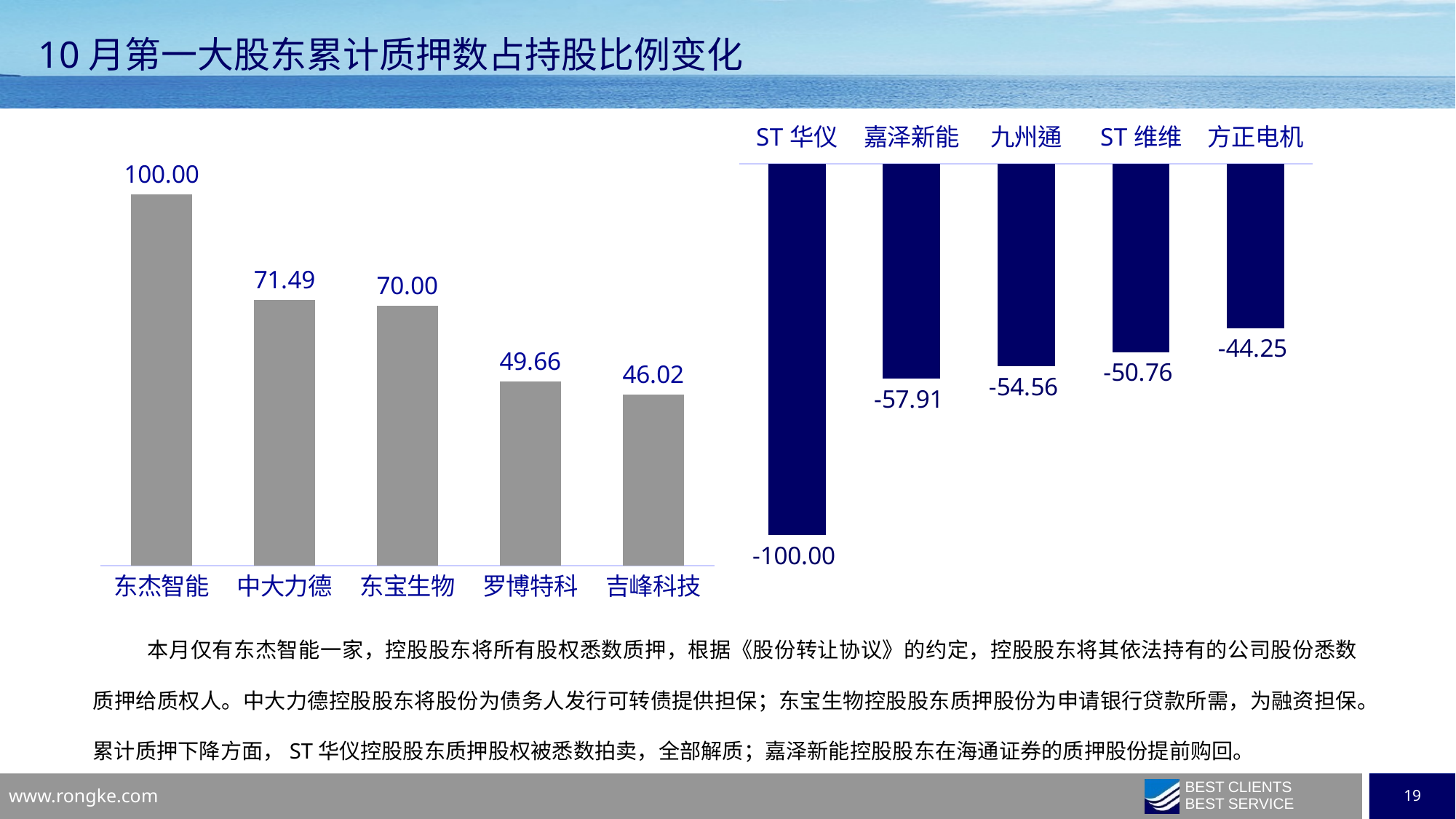
How many categories are shown in the right chart? 5 In the left chart, which category has the lowest value? 吉峰科技 In the left chart, which category has the highest value? 东杰智能 In the right chart, what is the value for 九州通? -54.56 In the left chart, what is the value for 吉峰科技? 46.02 In the right chart, what is the value for 方正电机? -44.25 In the right chart, which category has the lowest (most negative) value? ST 华仪 In the left chart, what is the value for 中大力德? 71.49 In the right chart, what is the difference between the values for 嘉泽新能 and ST 维维? 7.15 In the left chart, which is larger, the value for 罗博特科 or the value for 吉峰科技? 罗博特科 In the left chart, what is the difference between the values for 东杰智能 and 东宝生物? 30.00 What type of chart is the left chart? Bar chart